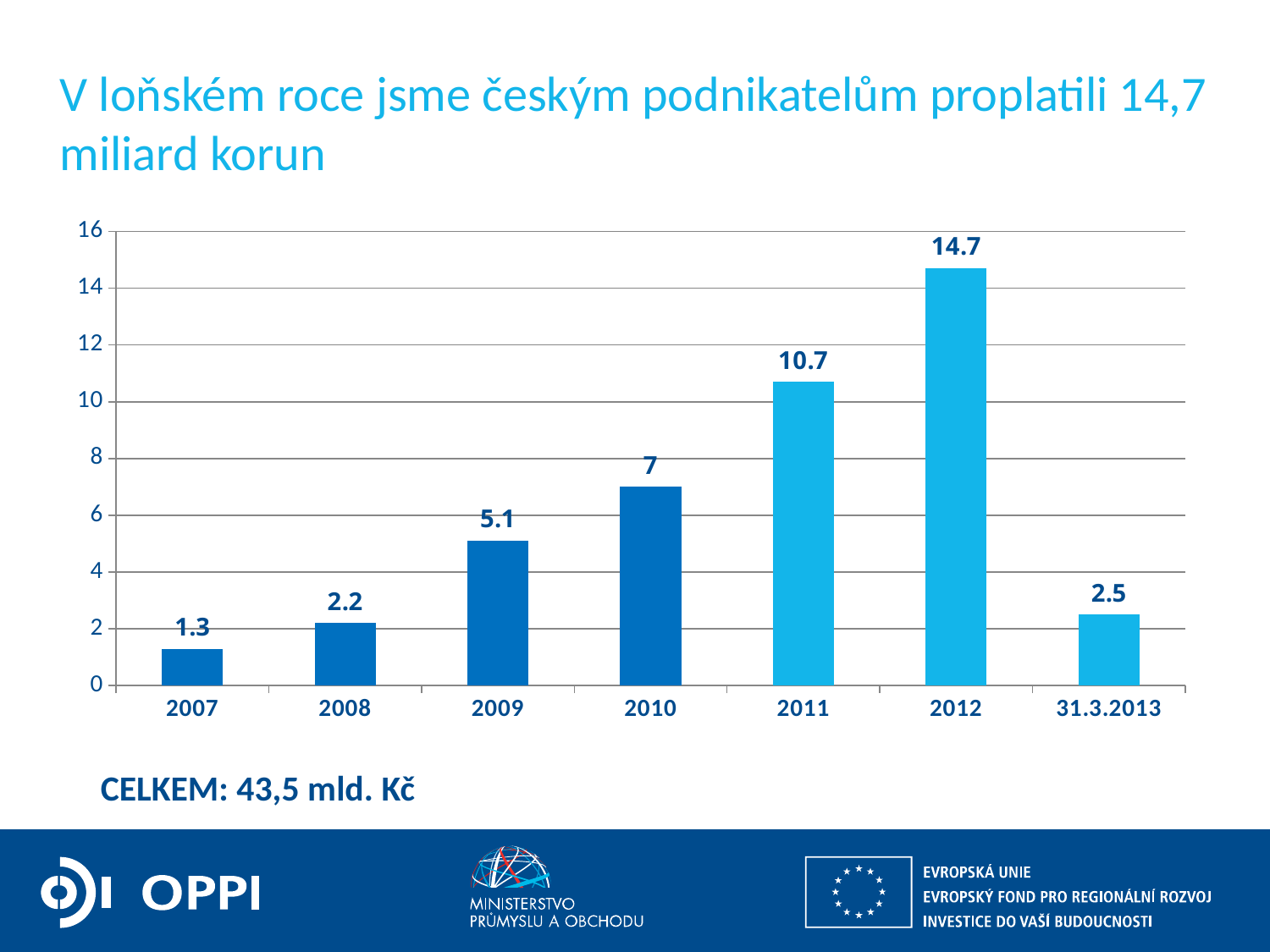
Do the values rise or fall from 2007 to 2012? rise Which category has the highest value? 2012 What is the value for 2009? 5.1 What kind of chart is shown on the slide? bar chart Which is larger, the value for 2009 or the value for 31.3.2013? 2009 What is the difference between the values for 2010 and 2008? 4.8 What is the value for 2012? 14.7 What is the difference between the values for 2012 and 2011? 4 What is the value for 31.3.2013? 2.5 Which category has the lowest value? 2007 How many categories are shown on the x axis? 7 Is the value for 2011 greater or less than 10? greater